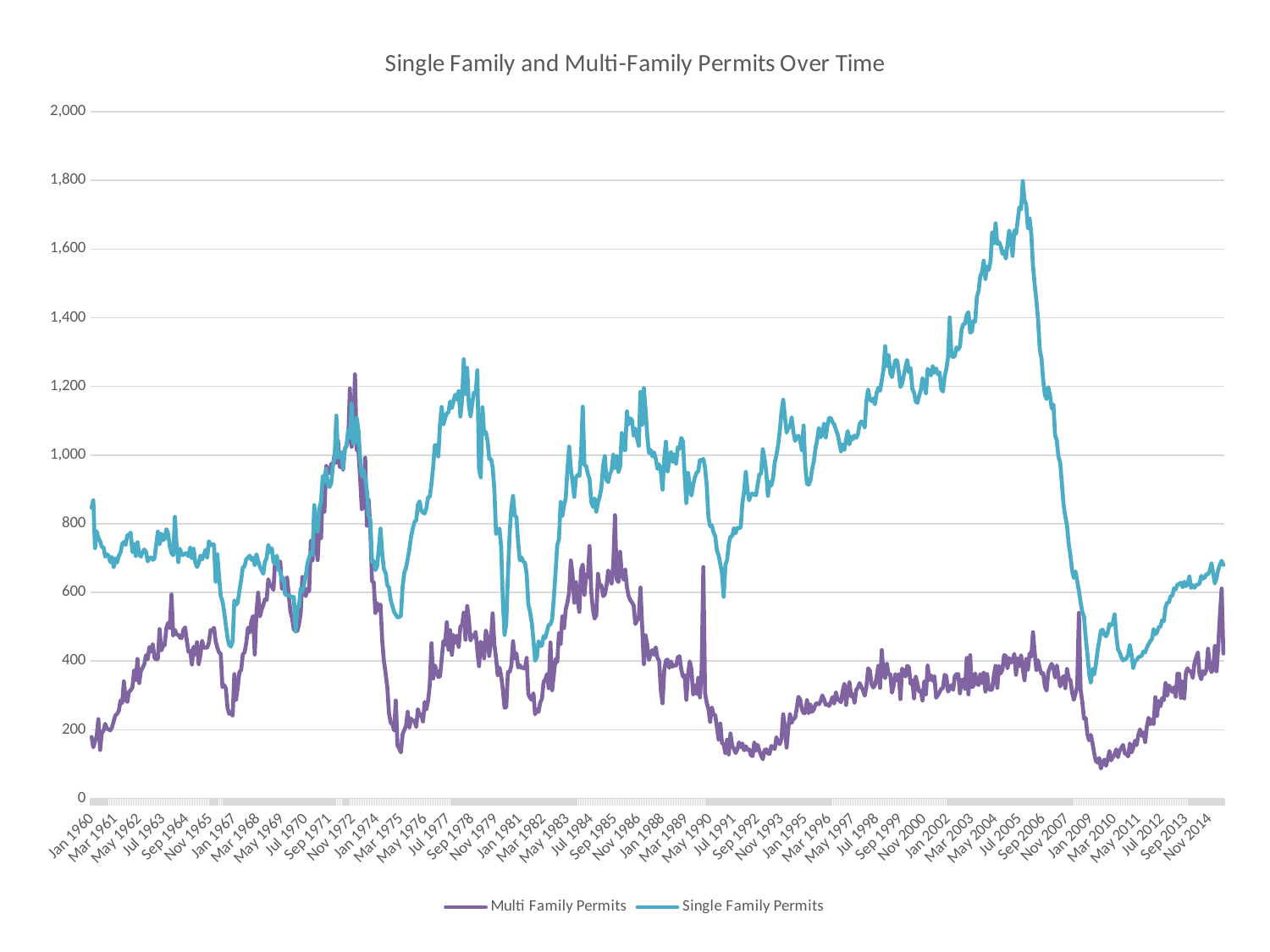
Which colour is used for the Single Family Permits line? Blue (teal) Is the value of Single Family Permits around Sep 2005 greater or less than 1,400? greater Which series reaches the highest value anywhere on the chart? Single Family Permits Around Jan 1991, which series has the higher value, Multi Family Permits or Single Family Permits? Single Family Permits Is the value of Multi Family Permits around Jan 2009 greater or less than 200? less Do Multi Family Permits rise or fall between Jan 2009 and Nov 2014? rise Is the value of Multi Family Permits around Jan 1975 greater or less than 200? less How many series does the legend list? 2 What kind of chart is shown on the slide? Line chart What is the title of the chart? Single Family and Multi-Family Permits Over Time Do Single Family Permits rise or fall between Jul 2005 and Jan 2009? fall